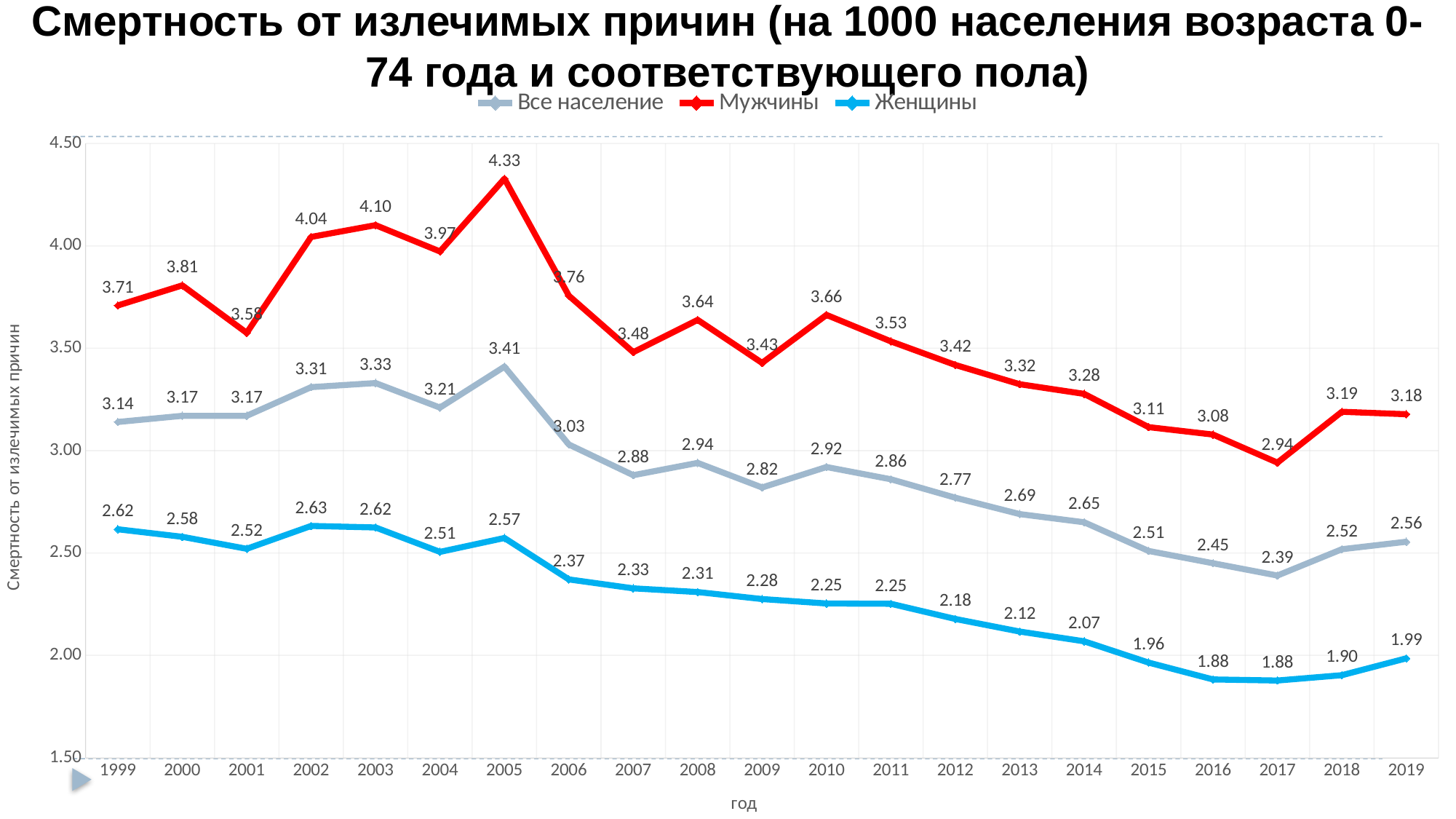
What kind of chart is shown on the slide? line chart How many series does the legend list? 3 What is the difference between the Мужчины and Женщины values in 2019? 1.19 By how much did the Все население value fall from 1999 to 2019? 0.58 Which year has the larger Мужчины value, 2002 or 2003? 2003 What is the value for Мужчины in 2005? 4.33 Is the value for Женщины in 2010 greater or less than 2.50? less What is the value for Все население in 2019? 2.56 What is the value for Женщины in 2016? 1.88 In which year does the Мужчины series reach its highest value? 2005 In which year does the Все население series reach its lowest value? 2017 How many years are plotted on the x axis? 21